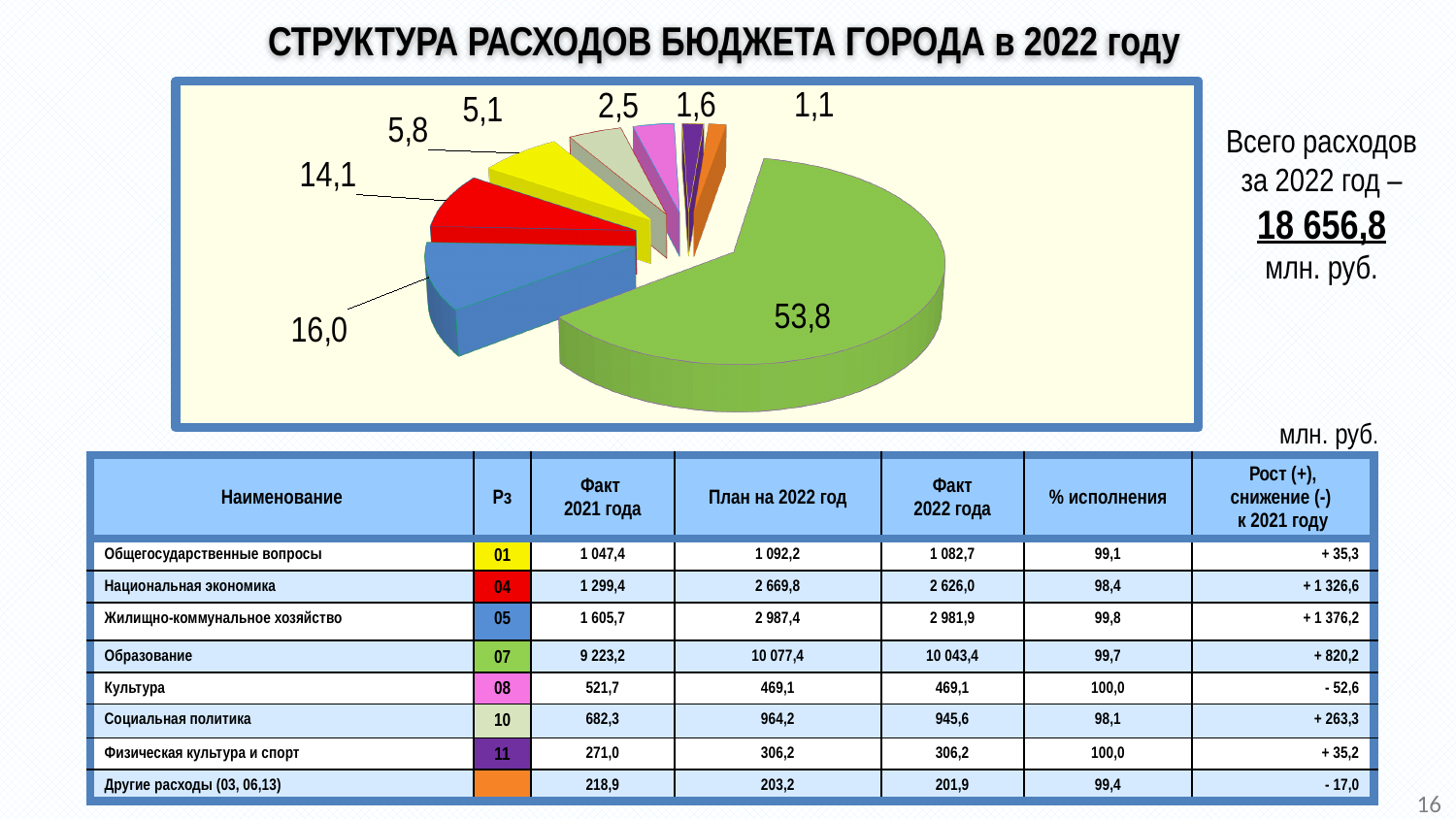
What is the value of the smallest slice of the pie chart? 1,1 What kind of chart is shown on the slide? pie chart What value is labelled on the yellow slice of the pie chart? 5,8 What value is labelled on the red slice of the pie chart? 14,1 What value is labelled on the blue slice of the pie chart? 16,0 What value is labelled on the green slice of the pie chart? 53,8 What is the difference between the blue slice (16,0) and the red slice (14,1) in the pie chart? 1,9 Which slice is larger in the pie chart: the yellow slice or the pink slice? the yellow slice What total expenditure for 2022 is stated next to the pie chart? 18 656,8 млн. руб. What is the value of the largest slice of the pie chart? 53,8 How many slices does the pie chart have? 8 What is the title of the slide containing the pie chart? СТРУКТУРА РАСХОДОВ БЮДЖЕТА ГОРОДА в 2022 году